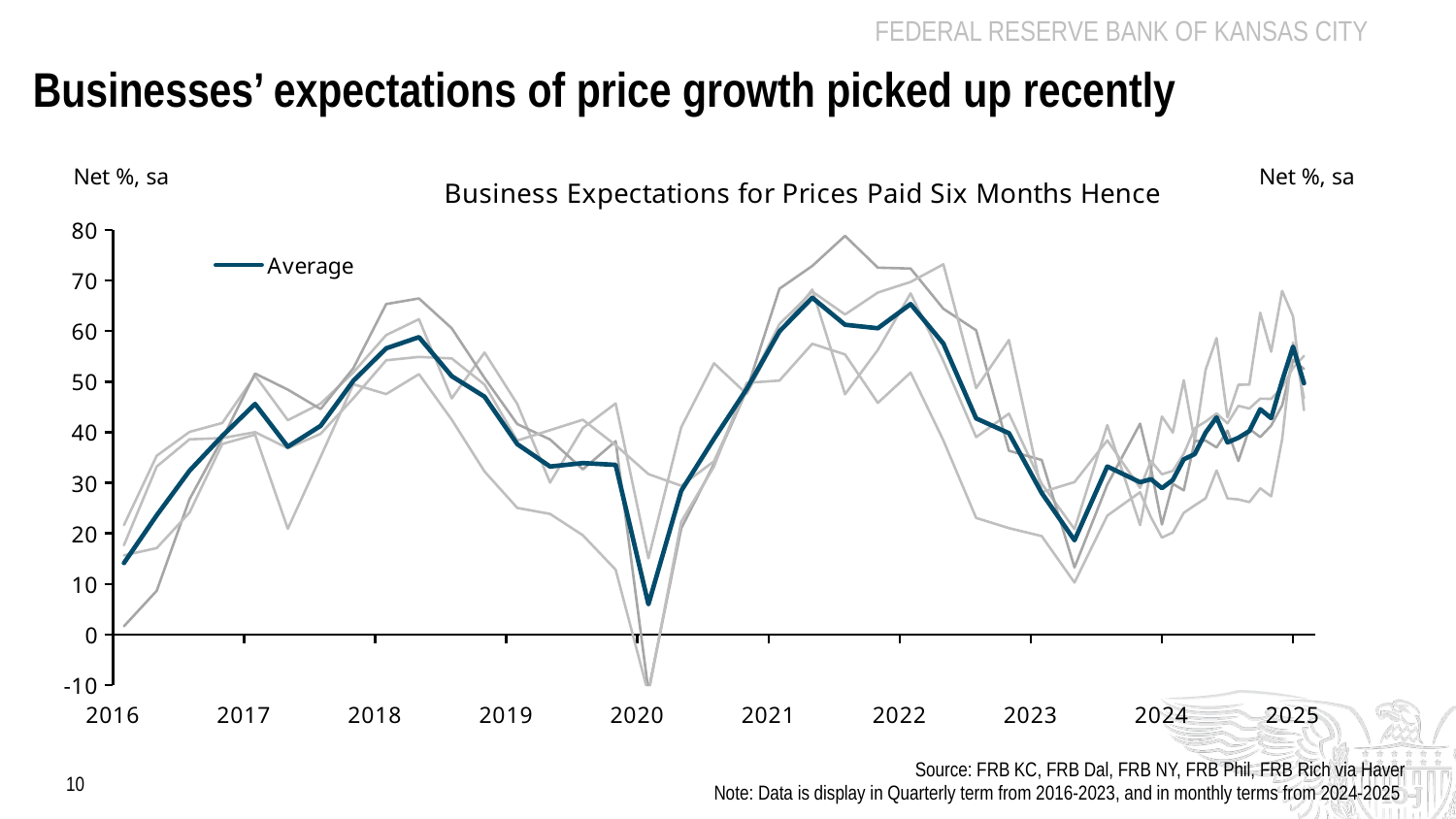
In which year does the Average line reach its lowest value? 2020 Does the Average line rise or fall between 2023 and 2025? Rise Is the peak of the Average line in 2021 greater or less than 60? greater Is the low point of the Average line in 2023 greater or less than 20? less Does the Average line rise or fall between 2018 and 2019? Fall What kind of chart is shown on the slide? Line chart Is the value of the Average line at the start of 2016 greater or less than 20? less How many year labels are shown on the x axis? 10 What is the title of the chart? Business Expectations for Prices Paid Six Months Hence Which series is named in the chart's legend? Average